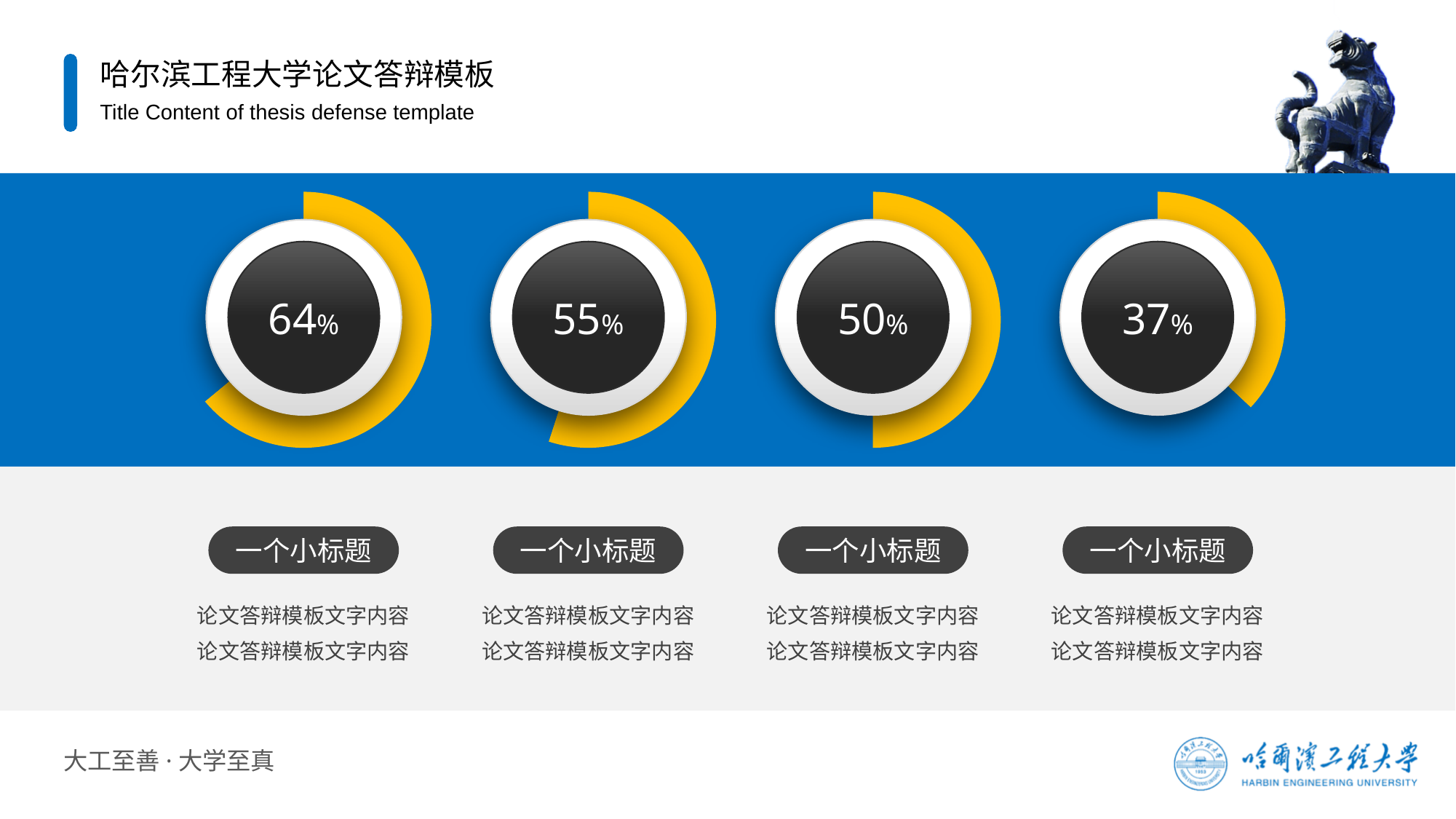
Which circular gauge shows the lowest value? The rightmost one (37%) What colour is the arc that indicates the percentage around each gauge? Yellow Which circular gauge shows the highest value? The leftmost one (64%) What value is shown in the third circular gauge from the left? 50% What is the difference between the values of the leftmost and rightmost gauges? 27% What value is shown in the second circular gauge from the left? 55% Which is larger, the value in the second gauge or the value in the fourth gauge? The second gauge (55%) How many circular gauges are shown on the slide? 4 What value is shown in the rightmost circular gauge? 37% What is the difference between the values of the second and third gauges from the left? 5% Do the gauge values rise or fall from left to right across the slide? Fall What value is shown in the leftmost circular gauge? 64%